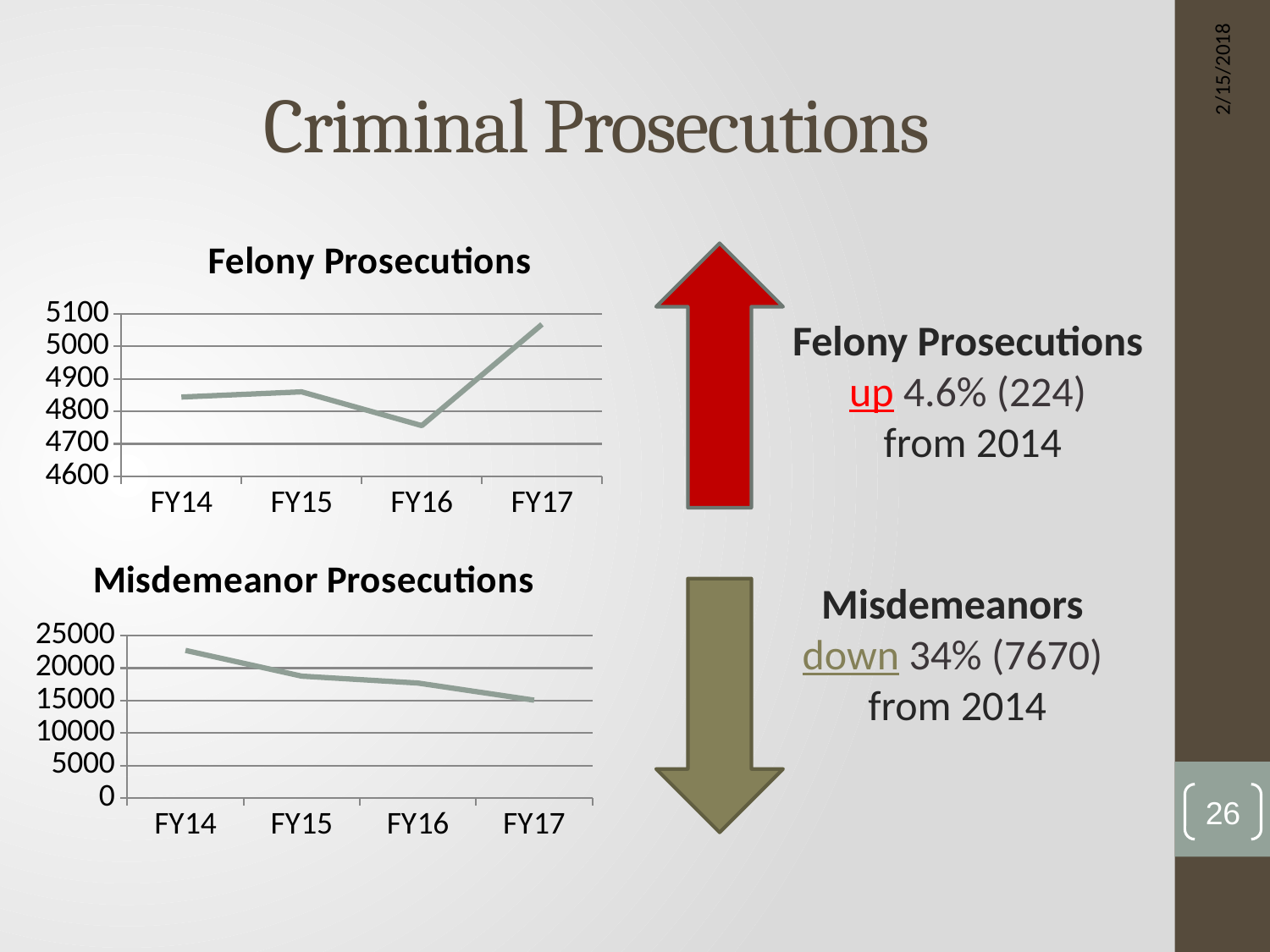
On the Misdemeanor Prosecutions chart, which fiscal year has the highest value? FY14 On the Felony Prosecutions chart, is the value for FY17 greater or less than 5000? greater How many fiscal years are plotted on the Misdemeanor Prosecutions chart? 4 What kind of chart is the Felony Prosecutions chart? line chart On the Misdemeanor Prosecutions chart, do the values rise or fall from FY14 to FY17? fall On the Misdemeanor Prosecutions chart, which fiscal year has the lowest value? FY17 On the Felony Prosecutions chart, which is larger, the value for FY16 or FY17? FY17 On the Felony Prosecutions chart, which fiscal year has the highest value? FY17 On the Felony Prosecutions chart, which fiscal year has the lowest value? FY16 What is the title of the lower chart on the slide? Misdemeanor Prosecutions On the Felony Prosecutions chart, is the value for FY16 greater or less than 4800? less On the Misdemeanor Prosecutions chart, is the value for FY14 greater or less than 20000? greater